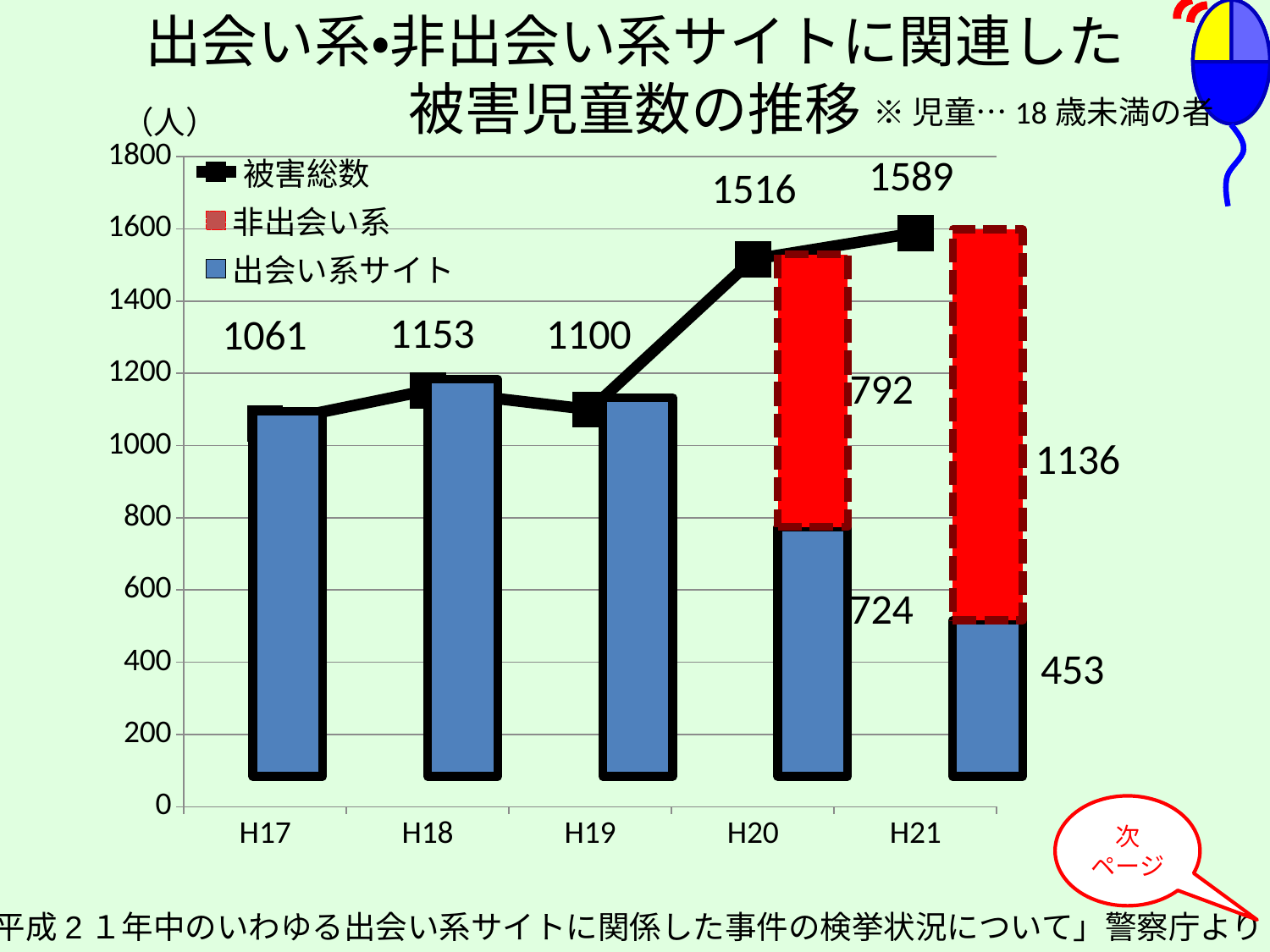
How many series does the legend list? 3 How many years are shown on the x axis? 5 Which year has the lowest 被害総数? H17 Which is larger, 非出会い系 for H20 or 出会い系サイト for H20? 非出会い系 for H20 What is the difference between 被害総数 for H21 and H20? 73 Is the value of 出会い系サイト for H21 greater or less than 600? less What is the total of the stacked bar for H20? 1516 What is the value of 被害総数 for H21? 1589 What is the value of 出会い系サイト for H20? 724 What is the value of 非出会い系 for H21? 1136 Which year has the highest 被害総数? H21 What is the value of 被害総数 for H17? 1061